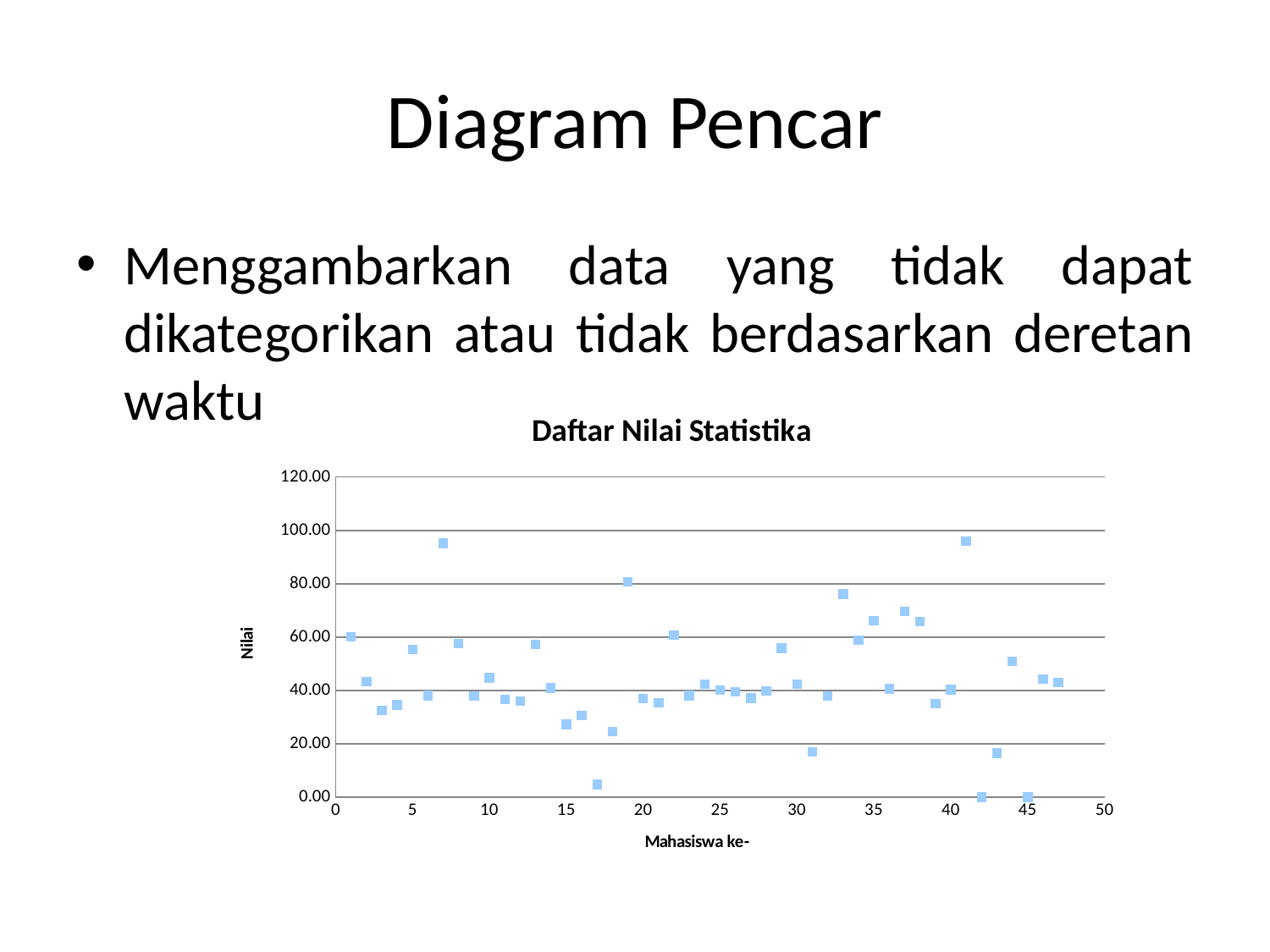
Which has the higher value, Mahasiswa ke-7 or Mahasiswa ke-17? Mahasiswa ke-7 Is the value for Mahasiswa ke-7 greater or less than 80.00? greater What kind of chart is shown on the slide? scatter chart Is the value for Mahasiswa ke-41 greater or less than 80.00? greater What is the title of the chart? Daftar Nilai Statistika Is the value for Mahasiswa ke-18 greater or less than 40.00? less Which has the higher value, Mahasiswa ke-33 or Mahasiswa ke-31? Mahasiswa ke-33 What is the label of the horizontal axis of the chart? Mahasiswa ke-